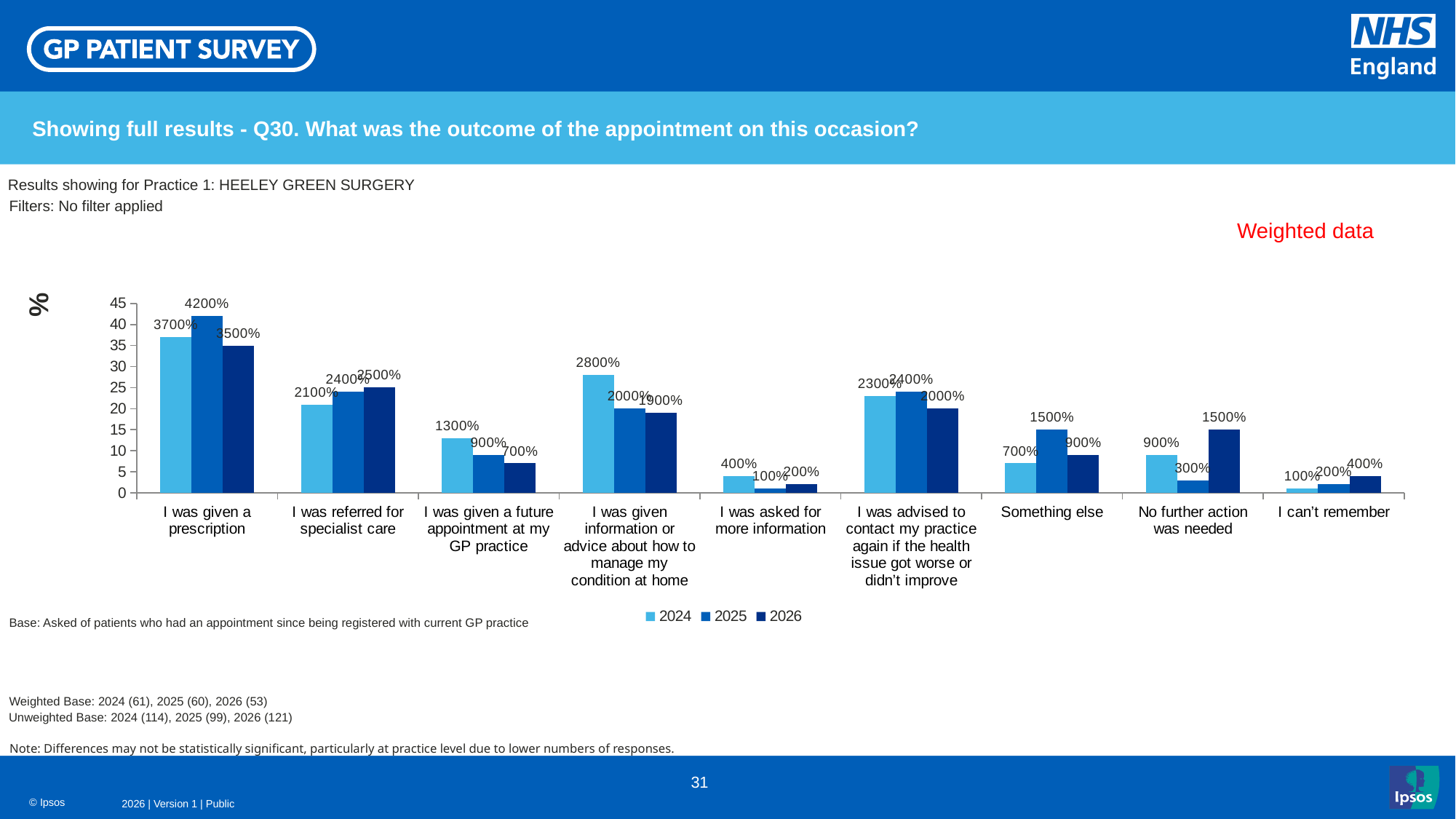
How many outcome categories are shown on the x axis? 9 What is the 2024 value for "I was given information or advice about how to manage my condition at home"? 2800% Which category has the highest 2024 value? I was given a prescription What is the 2025 value for "I was given a prescription"? 4200% What kind of chart is shown on the slide? Bar chart For "Something else", which year has the larger value, 2024 or 2025? 2025 How many series does the legend list? 3 What is the difference between the 2025 and 2026 values for "I was given a prescription"? 700% What is the 2026 value for "I was referred for specialist care"? 2500% Which category has the lowest 2025 value? I was asked for more information For "I was given a future appointment at my GP practice", do the values rise or fall from 2024 to 2026? Fall What is the 2026 value for "No further action was needed"? 1500%